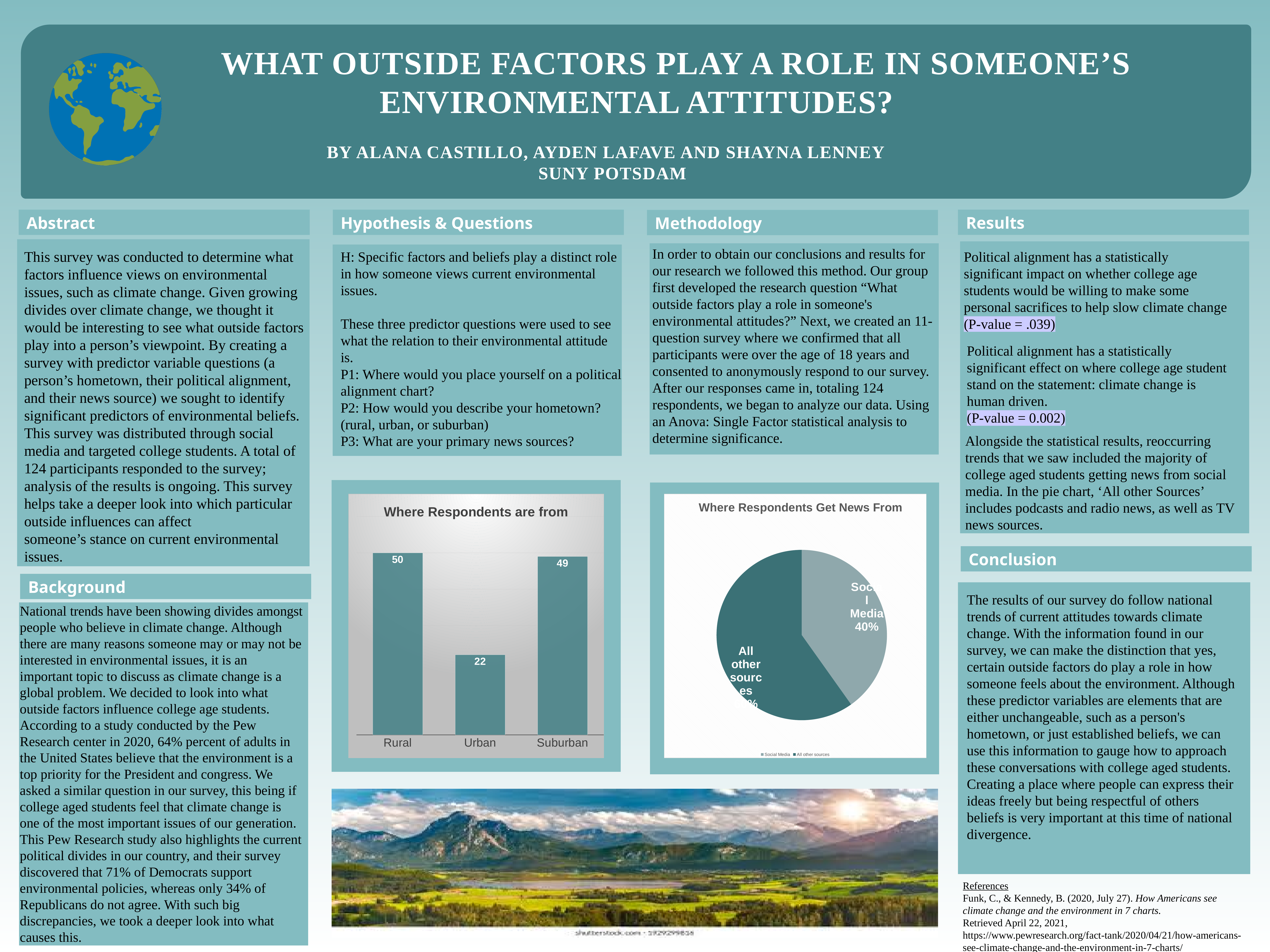
What kind of chart is 'Where Respondents Get News From'? Pie chart How many entries does the legend of the 'Where Respondents Get News From' chart list? 2 In the 'Where Respondents are from' chart, what is the value for Rural? 50 In the 'Where Respondents are from' chart, what is the value for Suburban? 49 How many categories are shown in the 'Where Respondents are from' chart? 3 In the 'Where Respondents are from' chart, which category has the lowest value? Urban In the 'Where Respondents are from' chart, which category has the highest value? Rural In the 'Where Respondents are from' chart, what is the value for Urban? 22 What kind of chart is 'Where Respondents are from'? Bar chart In the 'Where Respondents Get News From' chart, what share of respondents get news from Social Media? 40% In the 'Where Respondents are from' chart, what is the difference between the Rural and Urban values? 28 In the 'Where Respondents are from' chart, which is larger, the value for Suburban or the value for Urban? Suburban